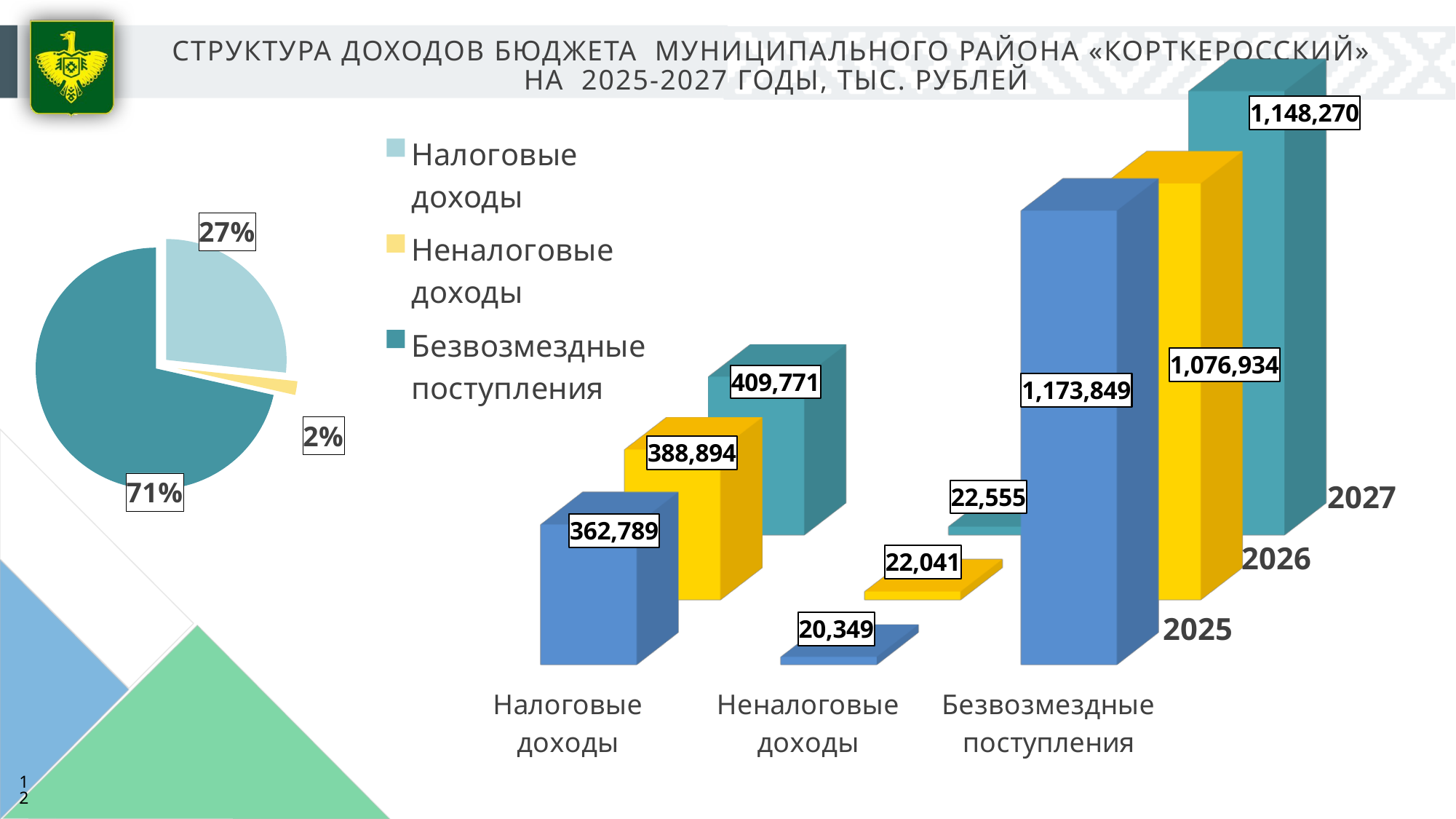
How many categories are shown on the x axis of the bar chart on the right? 3 In the bar chart on the right, what is the value for Налоговые доходы in 2025? 362,789 In the bar chart on the right, what is the difference between Налоговые доходы in 2027 and in 2025? 46,982 In the bar chart on the right, which year has the highest value for Безвозмездные поступления? 2025 In the pie chart on the left, what share is shown for Налоговые доходы? 27% In the bar chart on the right, which category has the lowest values across all years? Неналоговые доходы In the bar chart on the right, which is larger: Безвозмездные поступления in 2026 or in 2027? 2027 In the pie chart on the left, which category has the smallest slice? Неналоговые доходы In the bar chart on the right, what is the value for Неналоговые доходы in 2026? 22,041 In the bar chart on the right, what is the value for Безвозмездные поступления in 2027? 1,148,270 In the pie chart on the left, what share is shown for Безвозмездные поступления? 71% In the bar chart on the right, do the values for Налоговые доходы rise or fall from 2025 to 2027? rise